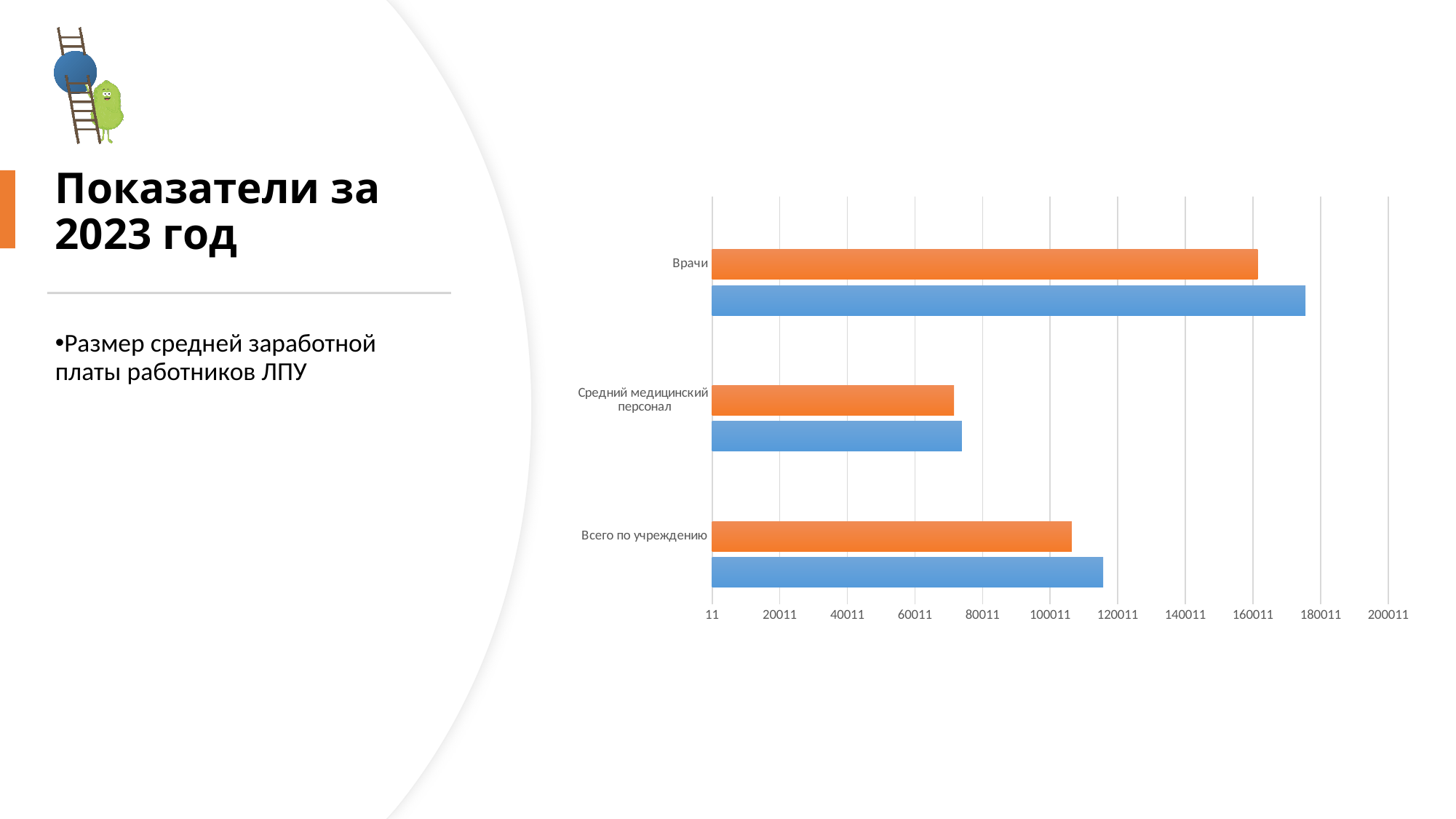
Is the orange bar value for Средний медицинский персонал greater or less than 80011? less For Врачи, which bar is longer, the orange one or the blue one? blue How many categories are shown on the chart? 3 Is the orange bar value for Всего по учреждению greater or less than 100011? greater Is the blue bar value for Всего по учреждению greater or less than 120011? less Which category has the shortest blue bar? Средний медицинский персонал How many bars are plotted for each category on the chart? 2 Which category has the longest orange bar? Врачи For Всего по учреждению, which bar is longer, the orange one or the blue one? blue What kind of chart is shown on the slide? bar chart